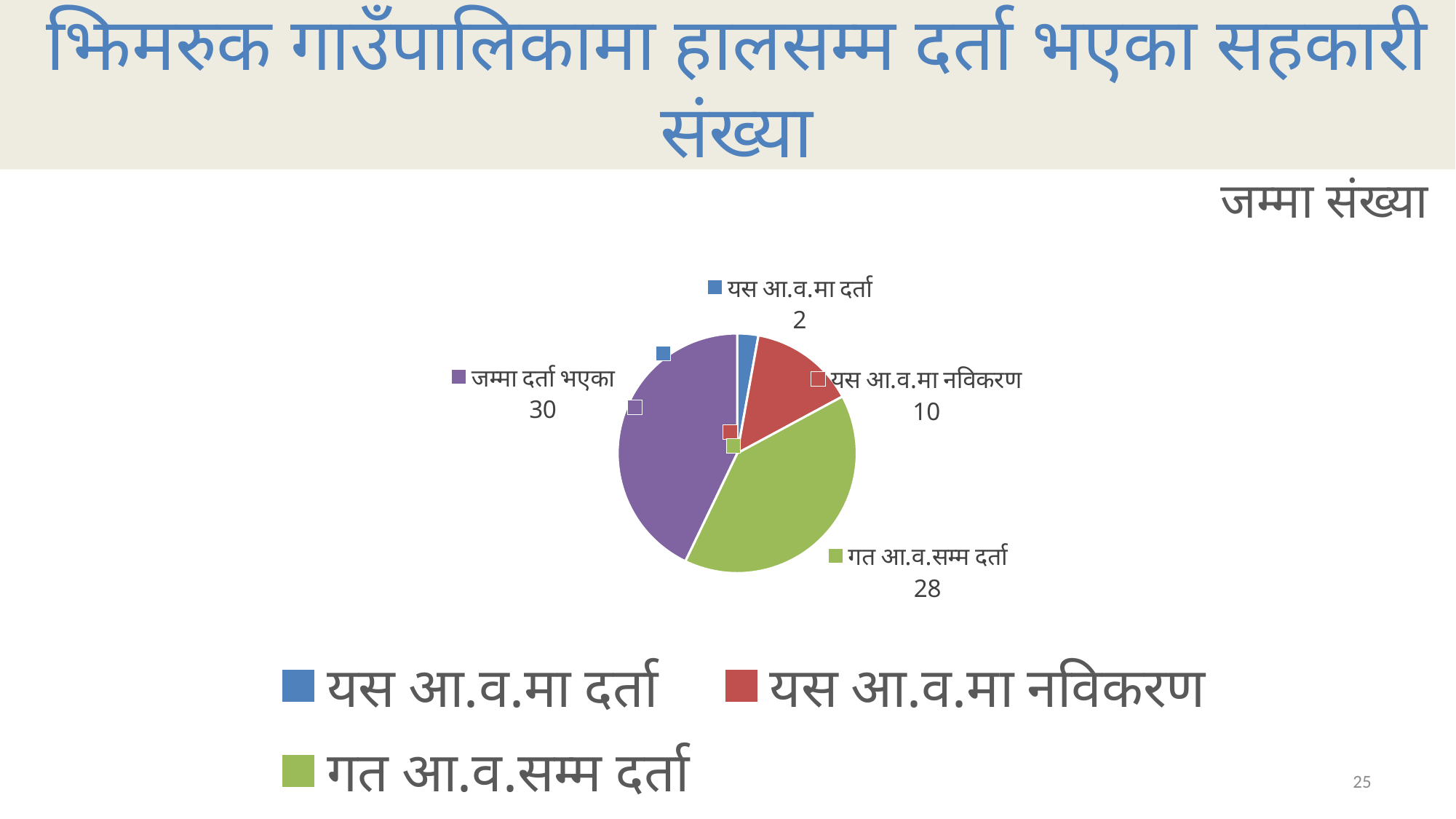
Which slice of the pie chart has the largest value? जम्मा दर्ता भएका How many slices does the pie chart have? 4 What is the value for गत आ.व.सम्म दर्ता in the pie chart? 28 What share of the pie does गत आ.व.सम्म दर्ता represent? 40% What is the value for यस आ.व.मा नविकरण in the pie chart? 10 What is the title shown above the pie chart? जम्मा संख्या What kind of chart is shown on the slide? pie chart What is the value for यस आ.व.मा दर्ता in the pie chart? 2 What is the difference between the values for यस आ.व.मा नविकरण and यस आ.व.मा दर्ता? 8 Which is larger, the value for गत आ.व.सम्म दर्ता or the value for यस आ.व.मा नविकरण? गत आ.व.सम्म दर्ता What is the value for जम्मा दर्ता भएका in the pie chart? 30 Which slice of the pie chart has the smallest value? यस आ.व.मा दर्ता